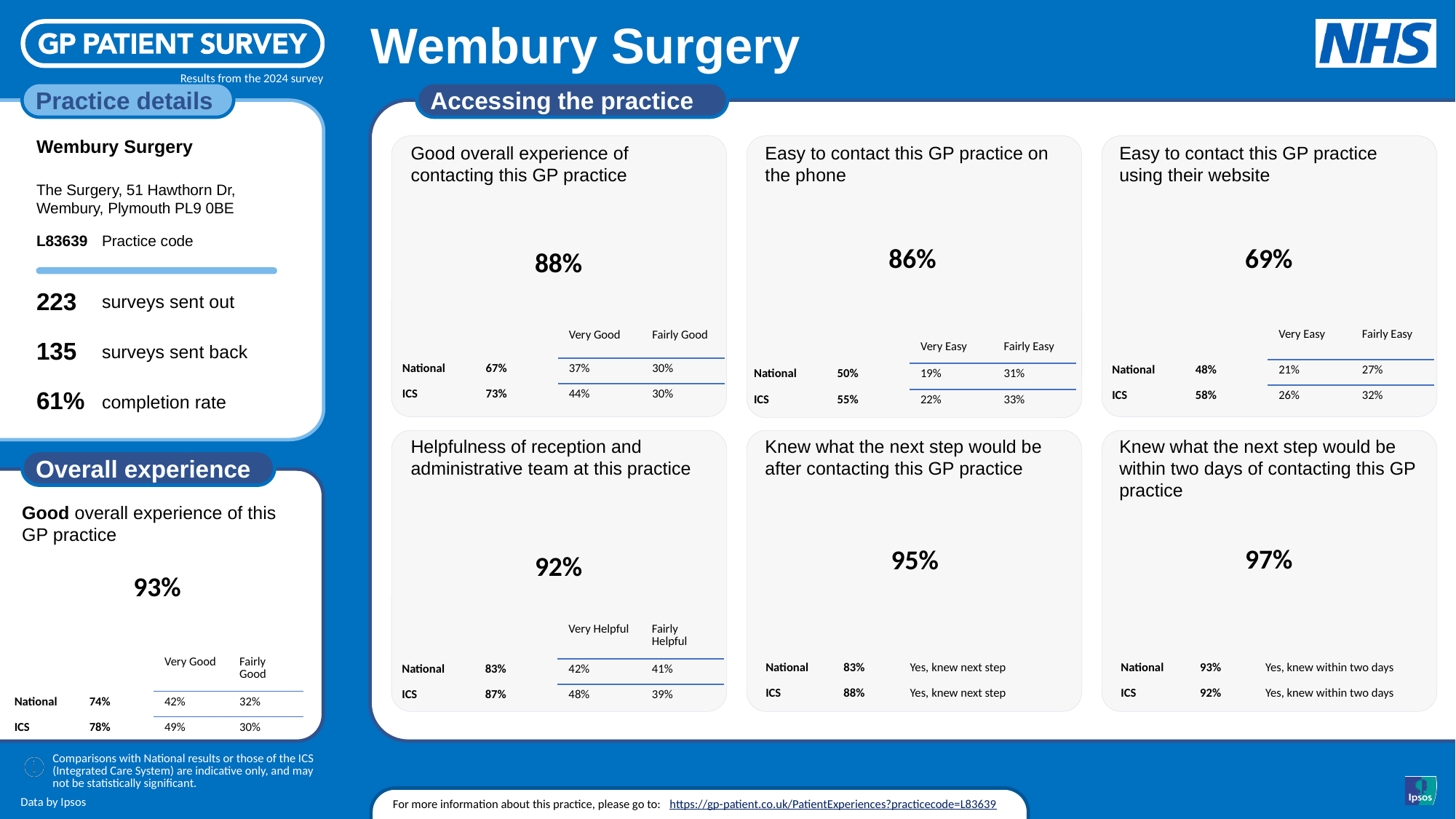
In the 'Helpfulness of reception and administrative team at this practice' panel, what is the National 'Very Helpful' percentage? 42% In the 'Good overall experience of contacting this GP practice' panel, what are the two response categories listed in the table header? Very Good, Fairly Good In the 'Good overall experience of contacting this GP practice' panel, what is the headline percentage for the practice? 88% In the 'Easy to contact this GP practice on the phone' panel, what is the National value? 50% In the 'Easy to contact this GP practice using their website' panel, what is the difference between the practice's headline percentage (69%) and the National value (48%)? 21% In the 'Knew what the next step would be after contacting this GP practice' panel, what is the practice's headline percentage? 95% In the 'Easy to contact this GP practice using their website' panel, what is the ICS value? 58% In the 'Easy to contact this GP practice on the phone' panel, which is larger: the ICS value or the National value? ICS How many panels are shown in the 'Accessing the practice' section? 6 Across the six 'Accessing the practice' panels, which measure has the highest headline percentage for the practice? Knew what the next step would be within two days of contacting this GP practice In the 'Good overall experience of this GP practice' panel under Overall experience, what is the ICS 'Fairly Good' percentage? 30% Across the six 'Accessing the practice' panels, which measure has the lowest headline percentage for the practice? Easy to contact this GP practice using their website